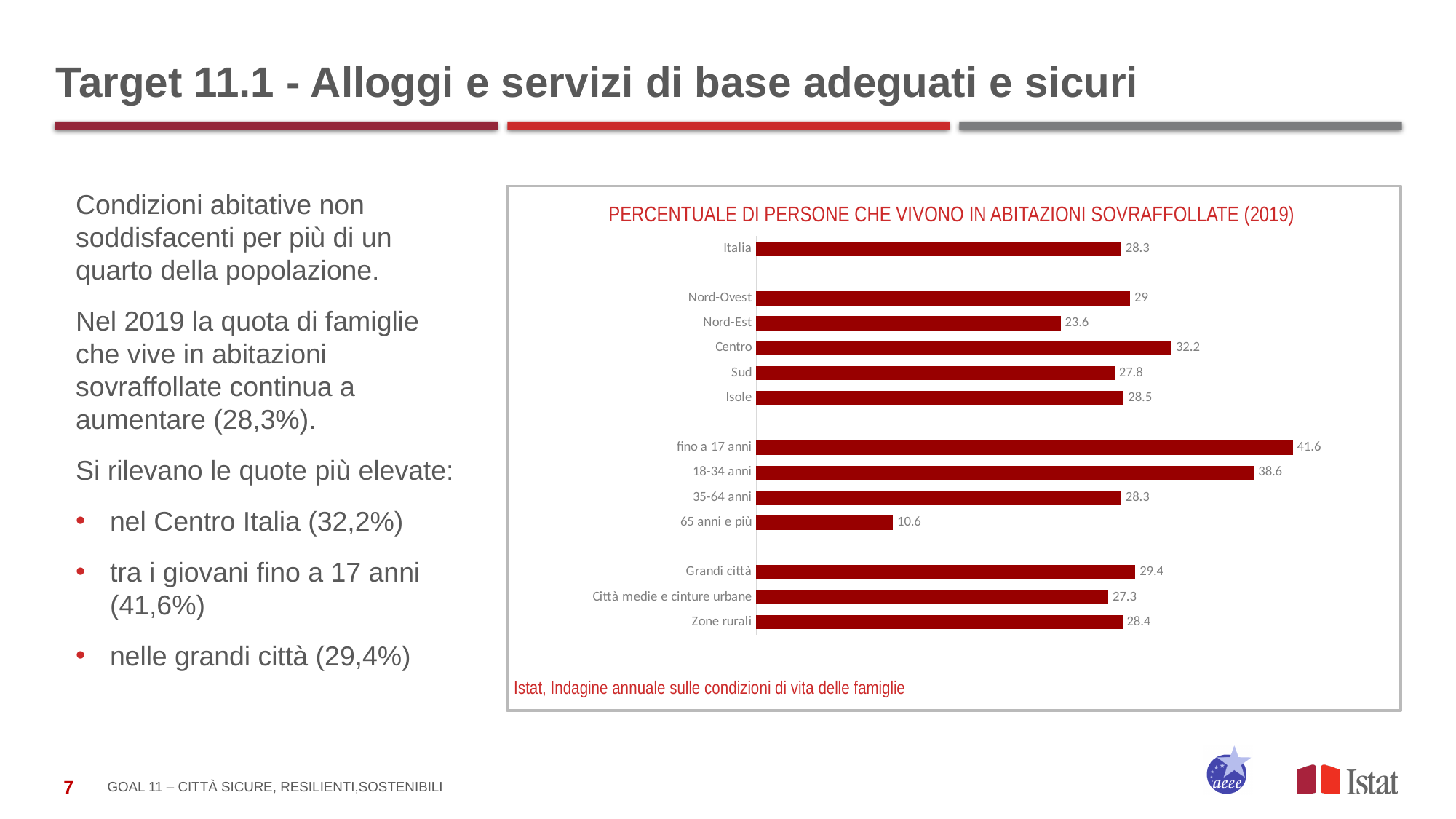
How many categories are plotted in the chart? 13 What is the value for Nord-Est? 23.6 Which category has the lowest value? 65 anni e più What is the value for 65 anni e più? 10.6 What kind of chart is shown on the slide? Bar chart What is the difference between the values for fino a 17 anni and 18-34 anni? 3 What is the difference between the values for Centro and Nord-Est? 8.6 Which is larger, the value for Nord-Ovest or the value for Sud? Nord-Ovest What is the value for Grandi città? 29.4 What is the title of the chart? PERCENTUALE DI PERSONE CHE VIVONO IN ABITAZIONI SOVRAFFOLLATE (2019) What is the value for Centro? 32.2 Which category has the highest value? fino a 17 anni